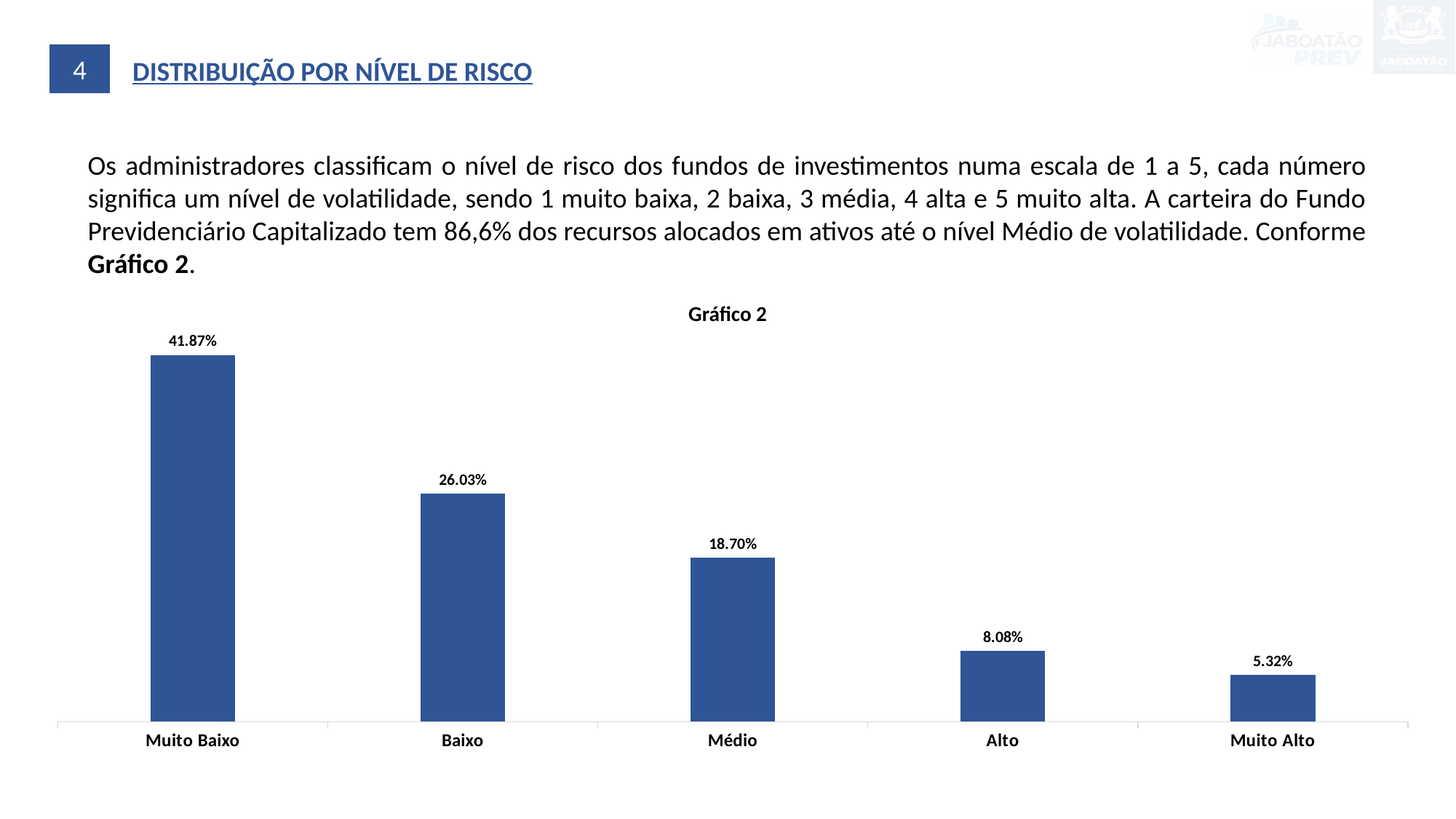
What is the difference between the values for Muito Baixo and Baixo? 15.84% What is the value for Muito Alto? 5.32% What is the difference between the values for Alto and Muito Alto? 2.76% What is the title of the chart? Gráfico 2 Do the values rise or fall from left to right along the x axis? Fall What is the value for Médio? 18.70% What is the value for Muito Baixo? 41.87% How many categories are shown on the x axis? 5 Which category has the lowest value? Muito Alto Which is larger, the value for Baixo or the value for Médio? Baixo What kind of chart is this? Bar chart Which category has the highest value? Muito Baixo